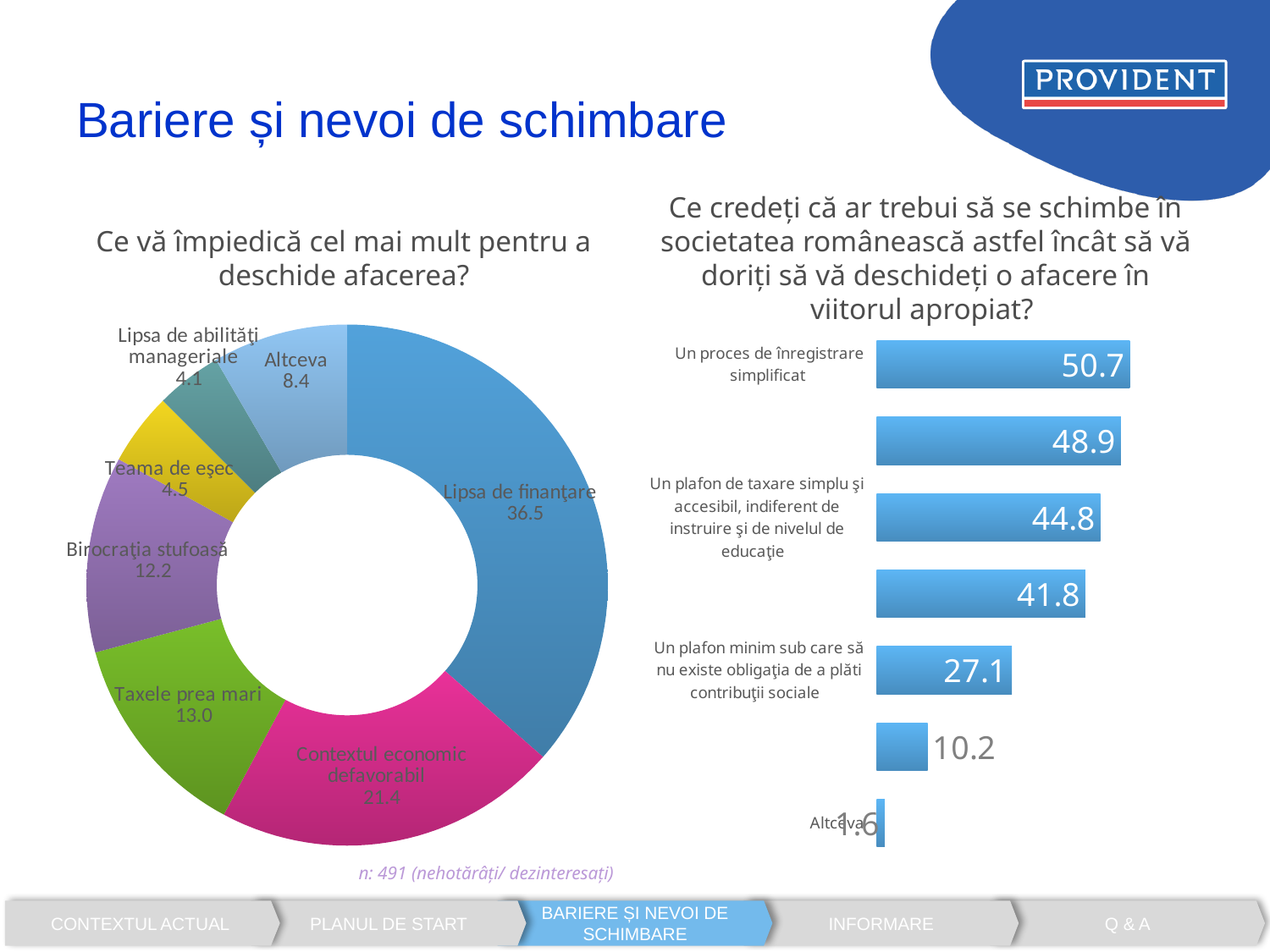
In the right chart (Ce credeți că ar trebui să se schimbe în societatea românească...), what is the value for Un proces de înregistrare simplificat? 50.7 In the left chart (Ce vă împiedică cel mai mult pentru a deschide afacerea?), which category has the smallest share? Lipsa de abilităţi manageriale In the left chart (Ce vă împiedică cel mai mult pentru a deschide afacerea?), how many slices are there? 7 What kind of chart is the right chart (Ce credeți că ar trebui să se schimbe în societatea românească...)? Bar chart In the right chart (Ce credeți că ar trebui să se schimbe în societatea românească...), what is the value for Un plafon minim sub care să nu existe obligaţia de a plăti contribuţii sociale? 27.1 What kind of chart is the left chart (Ce vă împiedică cel mai mult pentru a deschide afacerea?)? Doughnut (pie) chart In the left chart (Ce vă împiedică cel mai mult pentru a deschide afacerea?), what is the value for Birocraţia stufoasă? 12.2 In the left chart (Ce vă împiedică cel mai mult pentru a deschide afacerea?), what is the difference between Contextul economic defavorabil and Taxele prea mari? 8.4 In the right chart (Ce credeți că ar trebui să se schimbe în societatea românească...), which category has the highest value? Un proces de înregistrare simplificat In the right chart (Ce credeți că ar trebui să se schimbe în societatea românească...), which is larger: Un proces de înregistrare simplificat or Un plafon de taxare simplu şi accesibil, indiferent de instruire şi de nivelul de educaţie? Un proces de înregistrare simplificat In the left chart (Ce vă împiedică cel mai mult pentru a deschide afacerea?), which category has the largest share? Lipsa de finanţare In the left chart (Ce vă împiedică cel mai mult pentru a deschide afacerea?), what is the value for Lipsa de finanţare? 36.5